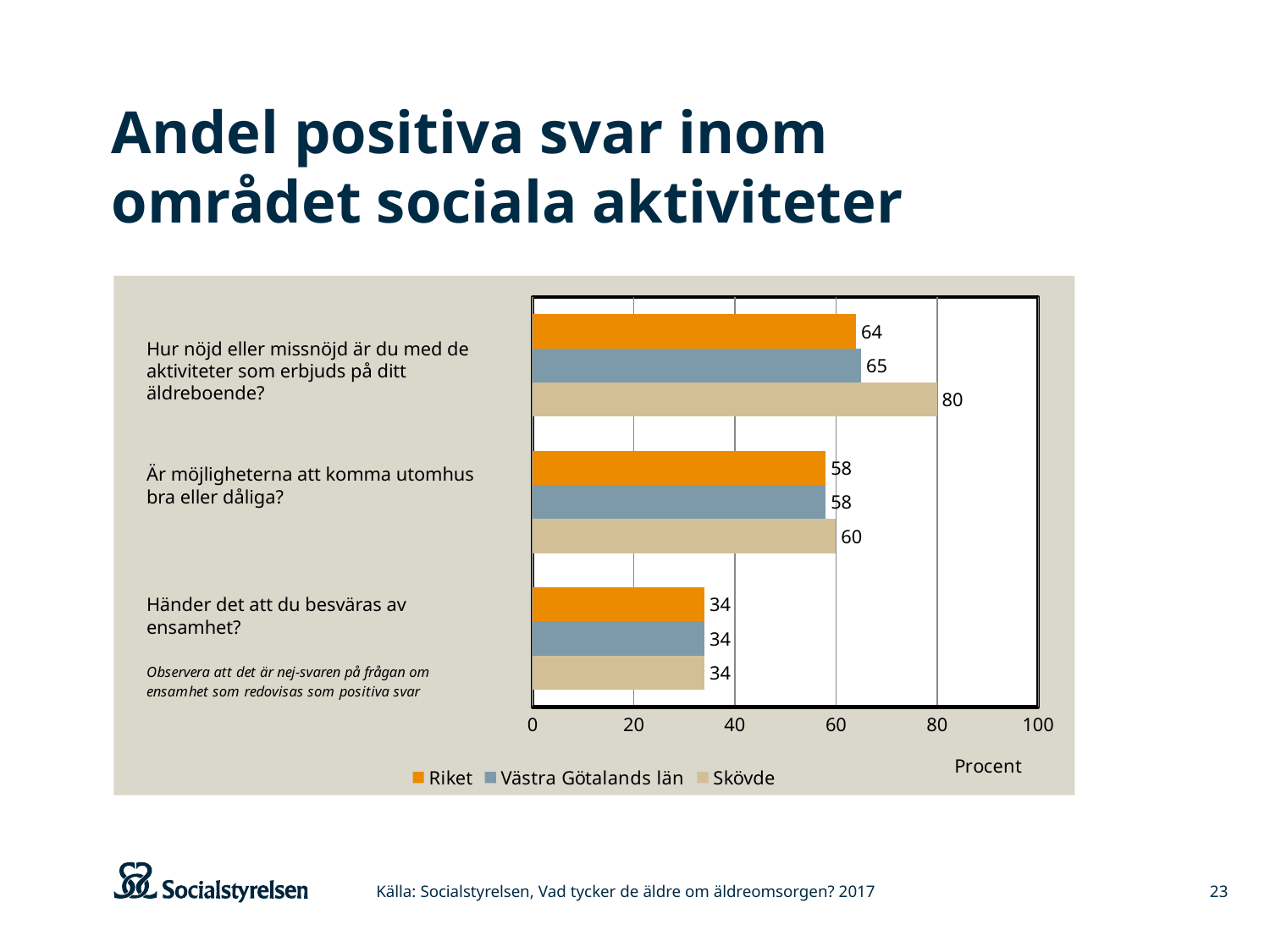
What is the value for Riket on the question "Är möjligheterna att komma utomhus bra eller dåliga?"? 58 Which series has the highest value on the question "Hur nöjd eller missnöjd är du med de aktiviteter som erbjuds på ditt äldreboende?"? Skövde What kind of chart is shown on the slide? Bar chart How many series does the legend list? 3 What is the label of the horizontal axis? Procent Which question has the lowest value for Skövde? Händer det att du besväras av ensamhet? What is the value for Västra Götalands län on the question "Hur nöjd eller missnöjd är du med de aktiviteter som erbjuds på ditt äldreboende?"? 65 What is the difference between the Skövde value and the Riket value on the question "Hur nöjd eller missnöjd är du med de aktiviteter som erbjuds på ditt äldreboende?"? 16 What is the value for Västra Götalands län on the question "Händer det att du besväras av ensamhet?"? 34 Which is larger on the question "Är möjligheterna att komma utomhus bra eller dåliga?": the value for Skövde or the value for Riket? Skövde What is the value for Skövde on the question "Hur nöjd eller missnöjd är du med de aktiviteter som erbjuds på ditt äldreboende?"? 80 How many questions (categories) are shown in the chart? 3